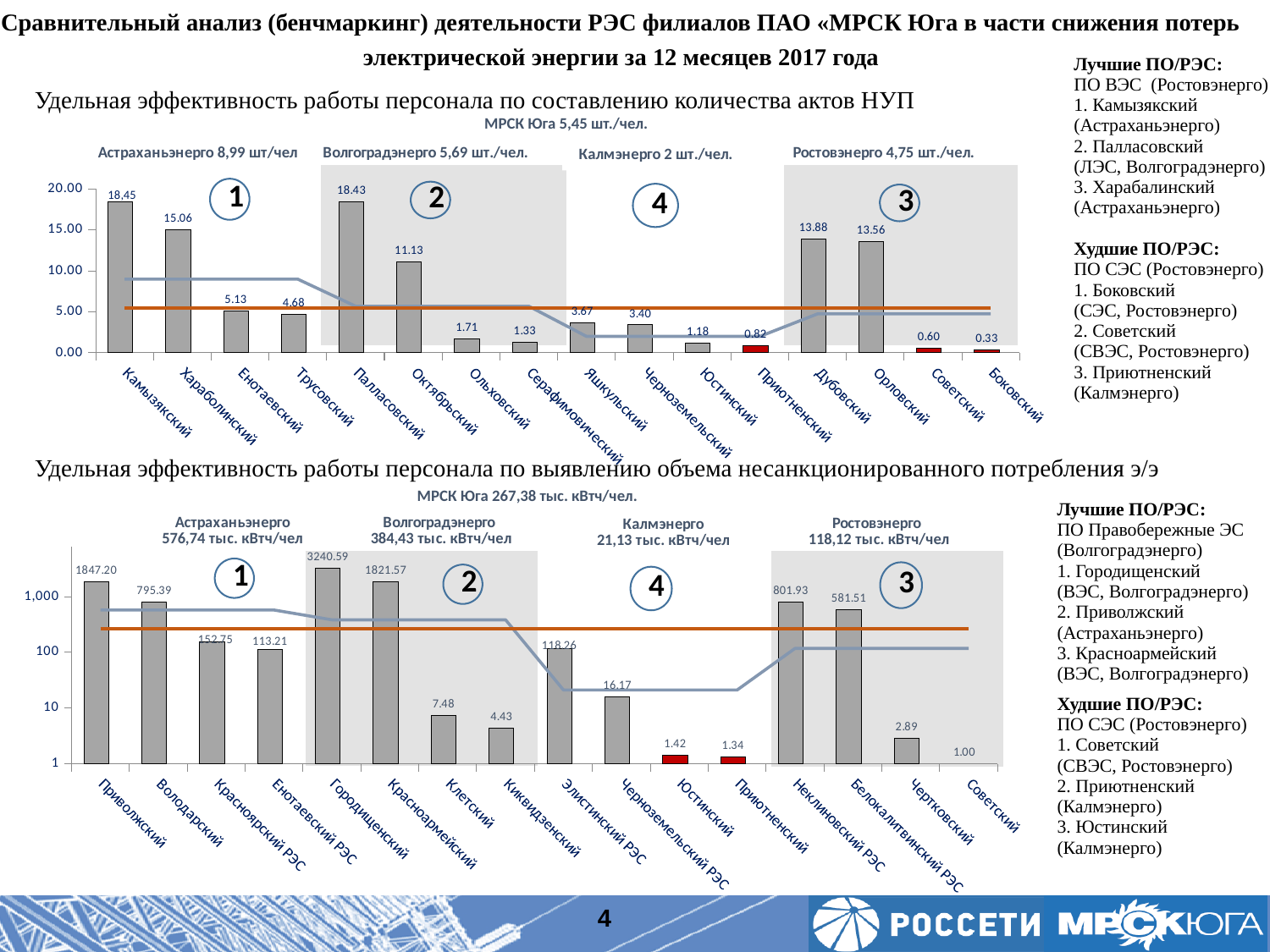
In the bottom chart (выявление объема несанкционированного потребления э/э), what is the value for Городищенский? 3240.59 In the top chart (составление количества актов НУП), which category has the lowest value? Боковский In the top chart (составление количества актов НУП), what is the value for Дубовский? 13.88 In the top chart (составление количества актов НУП), what is the value for Камызякский? 18,45 In the bottom chart (выявление объема несанкционированного потребления э/э), which is larger: Неклиновский РЭС or Белокалитвинский РЭС? Неклиновский РЭС In the top chart (составление количества актов НУП), what is the difference between Палласовский and Октябрьский? 7.30 What type of chart is the bottom chart (выявление объема несанкционированного потребления э/э)? Combination bar and line chart What is the МРСК Юга value shown above the top chart (составление количества актов НУП)? 5,45 шт./чел. In the top chart (составление количества актов НУП), which is larger: Яшкульский or Черноземельский? Яшкульский In the bottom chart (выявление объема несанкционированного потребления э/э), which category has the highest value? Городищенский In the top chart (составление количества актов НУП), how many categories are shown on the x axis? 16 In the bottom chart (выявление объема несанкционированного потребления э/э), what is the value for Советский? 1.00